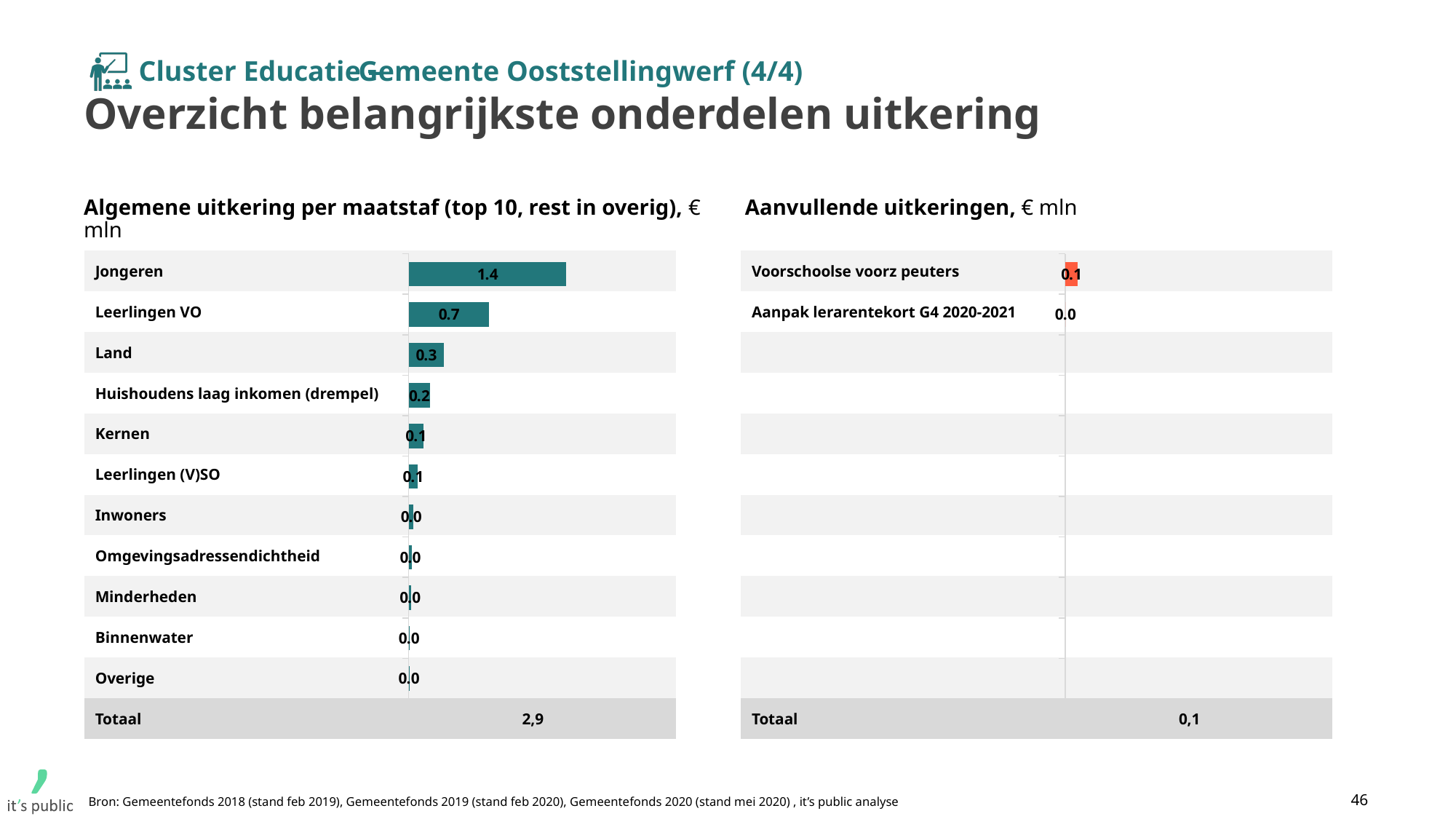
How many categories are shown in the 'Algemene uitkering per maatstaf' chart (excluding the Totaal row)? 11 In the 'Algemene uitkering per maatstaf' chart, what is the value for Jongeren? 1.4 In the 'Algemene uitkering per maatstaf' chart, what is the difference between Jongeren and Leerlingen VO? 0.7 In the 'Aanvullende uitkeringen' chart, what is the value for Aanpak lerarentekort G4 2020-2021? 0.0 In the 'Algemene uitkering per maatstaf' chart, what is the value for Leerlingen VO? 0.7 In the 'Aanvullende uitkeringen' chart, what is the value for Voorschoolse voorz peuters? 0.1 In the 'Algemene uitkering per maatstaf' chart, what is the value for Land? 0.3 In the 'Algemene uitkering per maatstaf' chart, which category has the highest value? Jongeren In the 'Algemene uitkering per maatstaf' chart, what is the value for Huishoudens laag inkomen (drempel)? 0.2 What is the Totaal shown for the 'Algemene uitkering per maatstaf' chart? 2,9 What type of chart is the 'Algemene uitkering per maatstaf' chart? Bar chart In the 'Algemene uitkering per maatstaf' chart, which is larger: Land or Huishoudens laag inkomen (drempel)? Land